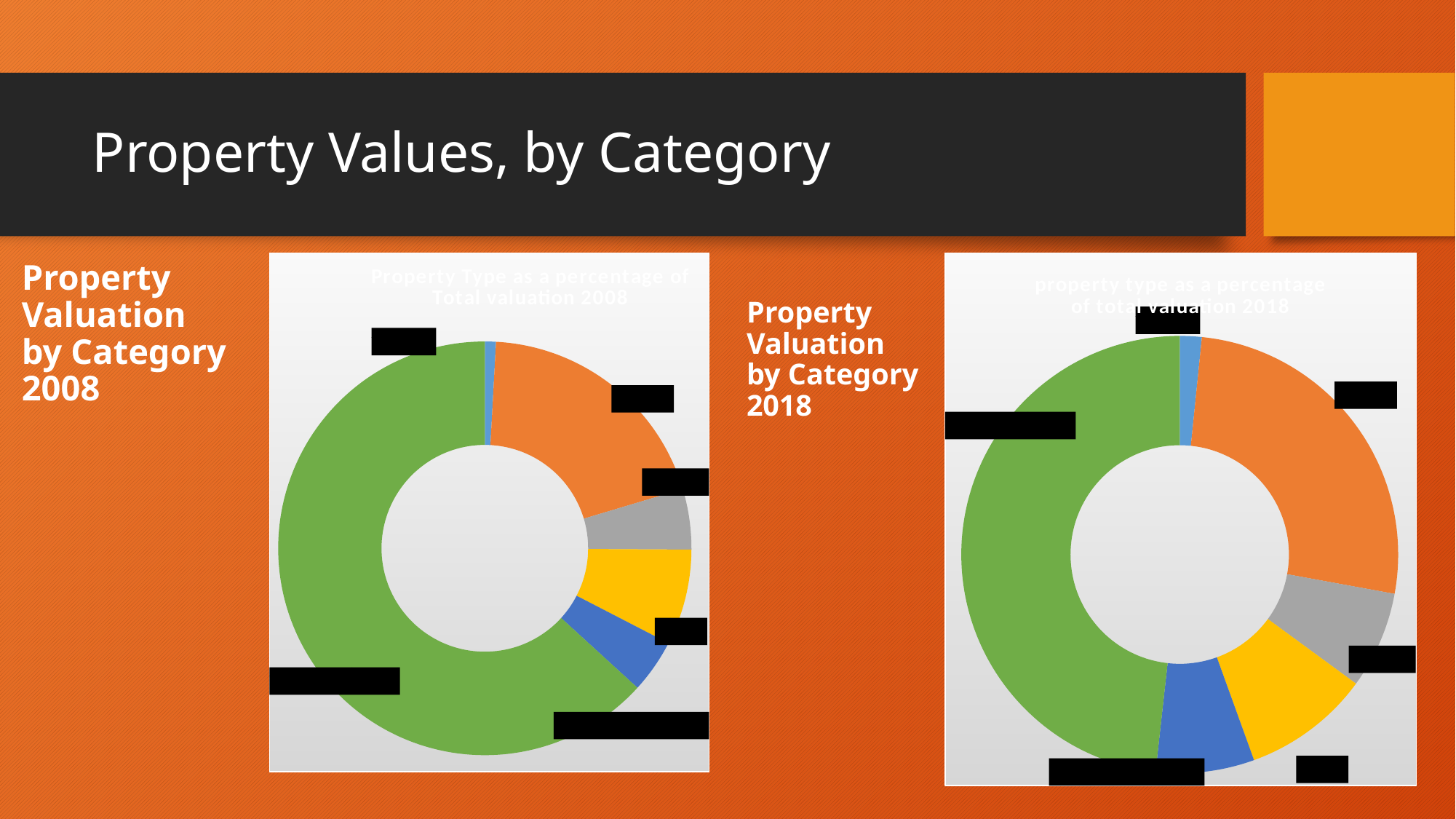
In the left chart (2008), how many slices does the doughnut have? 6 What kind of chart is the right chart, titled 'property type as a percentage of total valuation 2018'? doughnut chart What is the title of the left chart? Property Type as a percentage of Total valuation 2008 What kind of chart is the left chart, titled 'Property Type as a percentage of Total valuation 2008'? doughnut chart In the right chart (2018), which colour slice is the smallest? light blue In the left chart (2008), which colour slice is the smallest? light blue In the right chart (2018), how many slices does the doughnut have? 6 In the left chart (2008), is the green slice's share of the doughnut greater or less than 50%? greater In the left chart (2008), which colour slice is the largest? green In the right chart (2018), which colour slice is the largest? green In the left chart (2008), which is larger, the orange slice or the gray slice? orange What is the title of the right chart? property type as a percentage of total valuation 2018